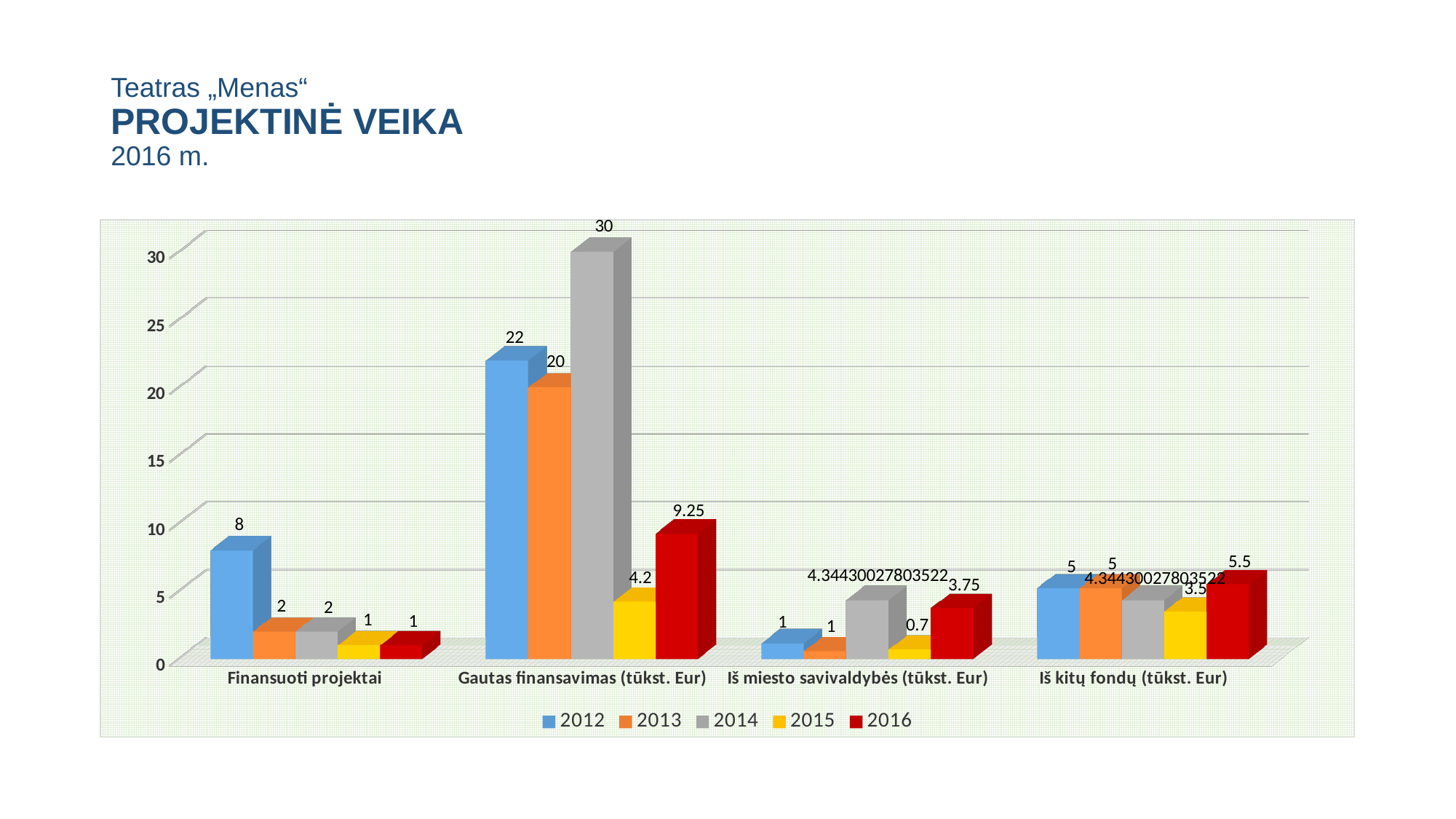
Which year has the lowest value in the Gautas finansavimas (tūkst. Eur) category? 2015 What is the value for 2012 in the Finansuoti projektai category? 8 What is the value for 2015 in the Iš miesto savivaldybės (tūkst. Eur) category? 0.7 How many categories are shown on the x axis? 4 How many series does the legend list? 5 What is the difference between the 2012 and 2013 values in the Gautas finansavimas (tūkst. Eur) category? 2 What is the value for 2016 in the Iš kitų fondų (tūkst. Eur) category? 5.5 Which is larger in the Iš miesto savivaldybės (tūkst. Eur) category: the 2016 value or the 2015 value? 2016 What is the value for 2016 in the Gautas finansavimas (tūkst. Eur) category? 9.25 What kind of chart is shown on the slide? Bar chart What is the value for 2014 in the Gautas finansavimas (tūkst. Eur) category? 30 Which year has the highest value in the Gautas finansavimas (tūkst. Eur) category? 2014